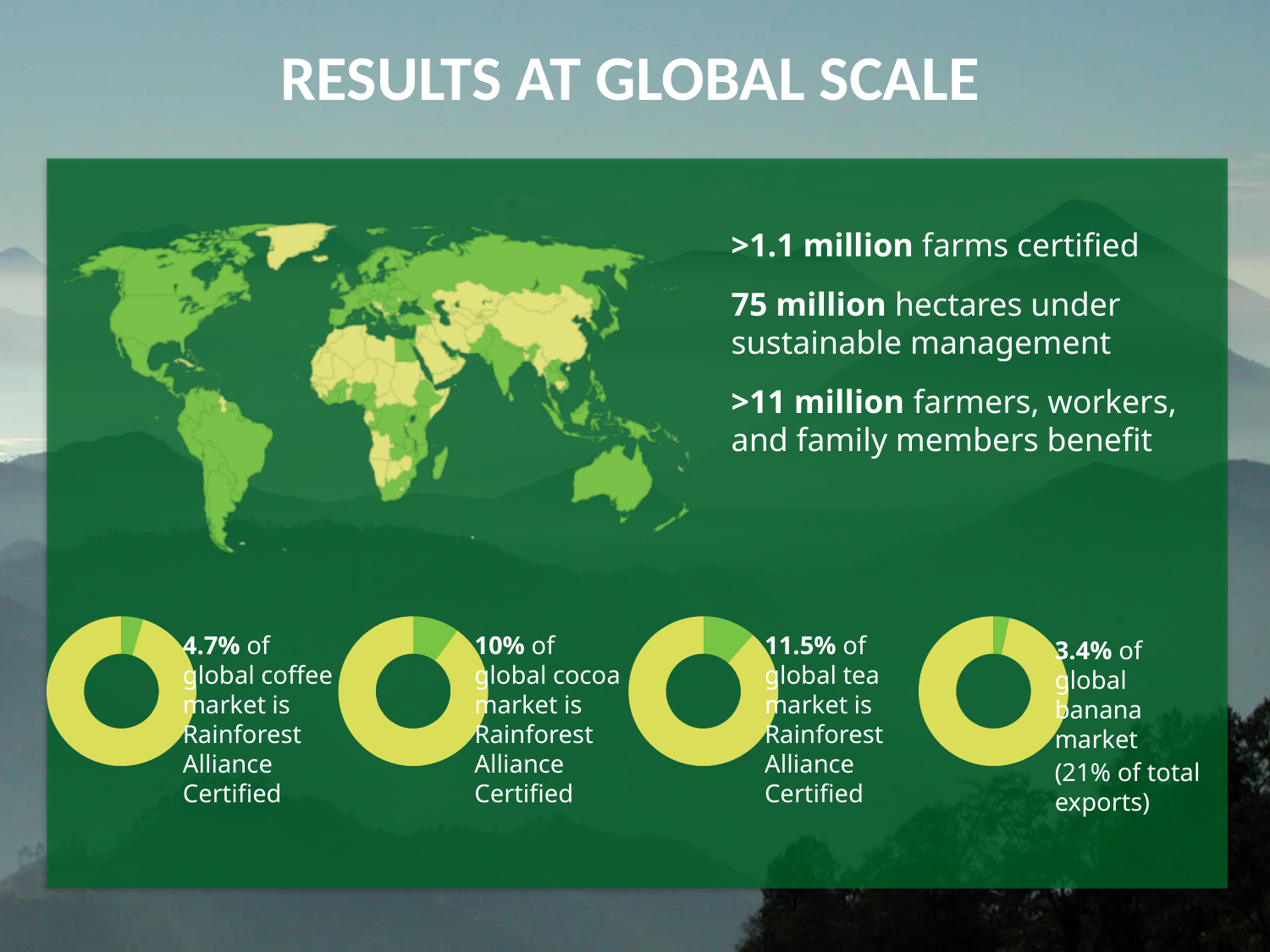
Comparing the tea and coffee donut charts, what is the difference between their Rainforest Alliance Certified shares? 6.8% Which has a larger Rainforest Alliance Certified share, the cocoa market or the coffee market? cocoa In the donut chart for the global coffee market, what share is Rainforest Alliance Certified? 4.7% In the donut chart for the global cocoa market, what share is Rainforest Alliance Certified? 10% In the donut chart for the global tea market, what share is Rainforest Alliance Certified? 11.5% In the donut chart for the global banana market, what share is Rainforest Alliance Certified? 3.4% In the banana market donut chart, what percentage of total exports is noted in parentheses? 21% How many donut charts are shown at the bottom of the slide? 4 Comparing the cocoa and banana donut charts, what is the difference between their Rainforest Alliance Certified shares? 6.6% Among the four donut charts at the bottom of the slide, which commodity has the highest Rainforest Alliance Certified share? tea What kind of chart is used to show the certified share of each commodity market at the bottom of the slide? donut chart Among the four donut charts at the bottom of the slide, which commodity has the lowest Rainforest Alliance Certified share? banana